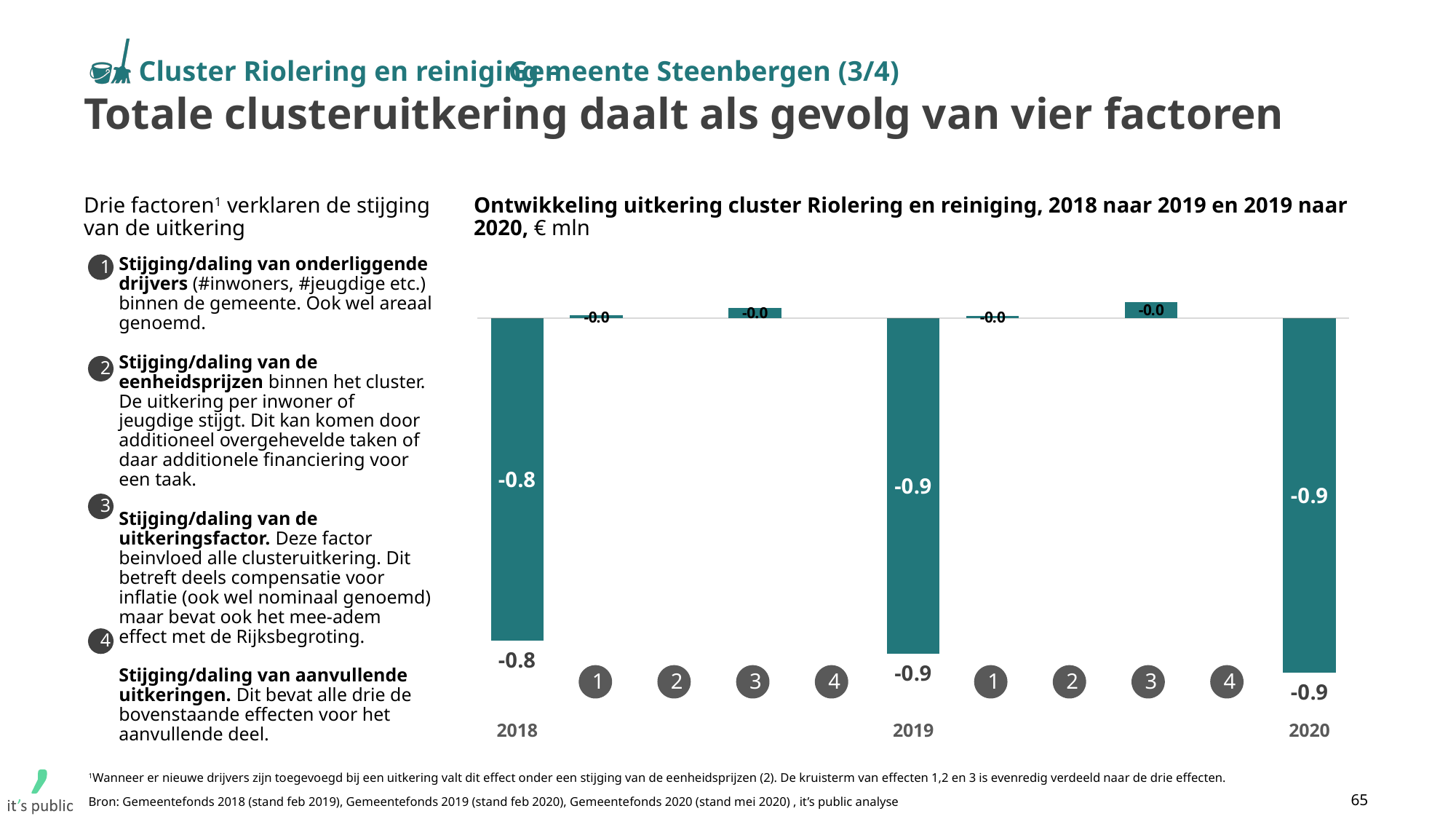
How many year totals (2018, 2019, 2020) are plotted in the chart? 3 What is the value shown for 2018 in the chart? -0.8 What is the value shown for 2020 in the chart? -0.9 Do the year totals rise or fall from 2018 to 2020? Fall What value is labelled for factor 3 in the 2019-to-2020 step? -0.0 In what unit are the values in the chart expressed? € mln What is the difference between the 2018 value and the 2019 value? 0.1 What value is labelled for factor 1 in the 2018-to-2019 step? -0.0 What is the title of the chart? Ontwikkeling uitkering cluster Riolering en reiniging, 2018 naar 2019 en 2019 naar 2020, € mln Which year has the highest (least negative) value: 2018 or 2019? 2018 What is the value shown for 2019 in the chart? -0.9 What kind of chart is shown on the slide? Bar chart